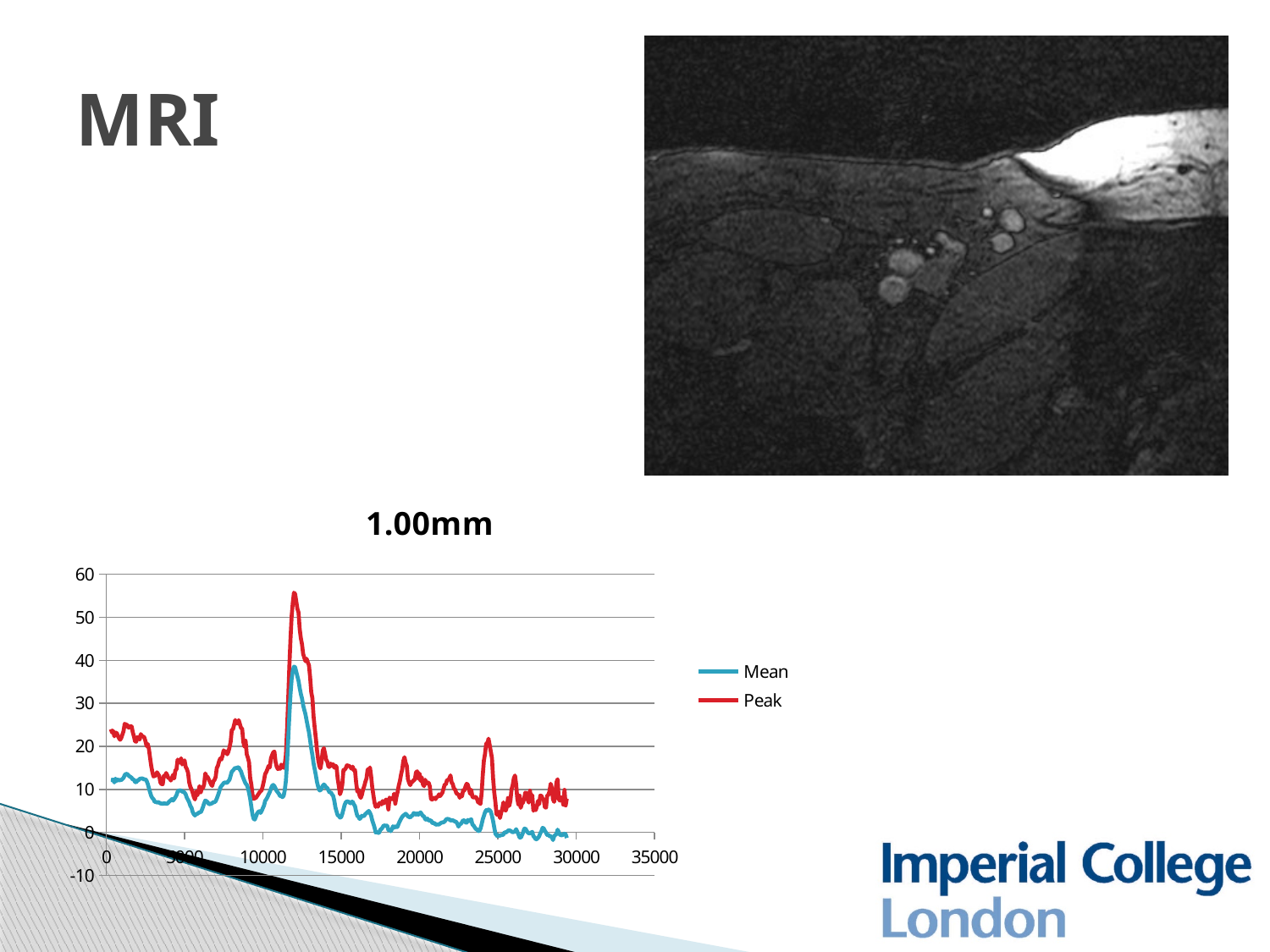
Overall, do the Mean values rise or fall from the start to the end of the x axis? fall Which series is lower across the whole x axis, Mean or Peak? Mean What kind of chart is shown on the slide? line chart Which series is drawn in red in the chart? Peak What is the title of the chart? 1.00mm How many series does the legend of the chart list? 2 Is the Peak value at x = 0 greater or less than 20? greater Is the Mean value near x = 30000 greater or less than 10? less Is the highest value of the Peak series greater or less than 50? greater Which series reaches the higher maximum value, Mean or Peak? Peak What is the highest value shown on the y axis of the chart? 60